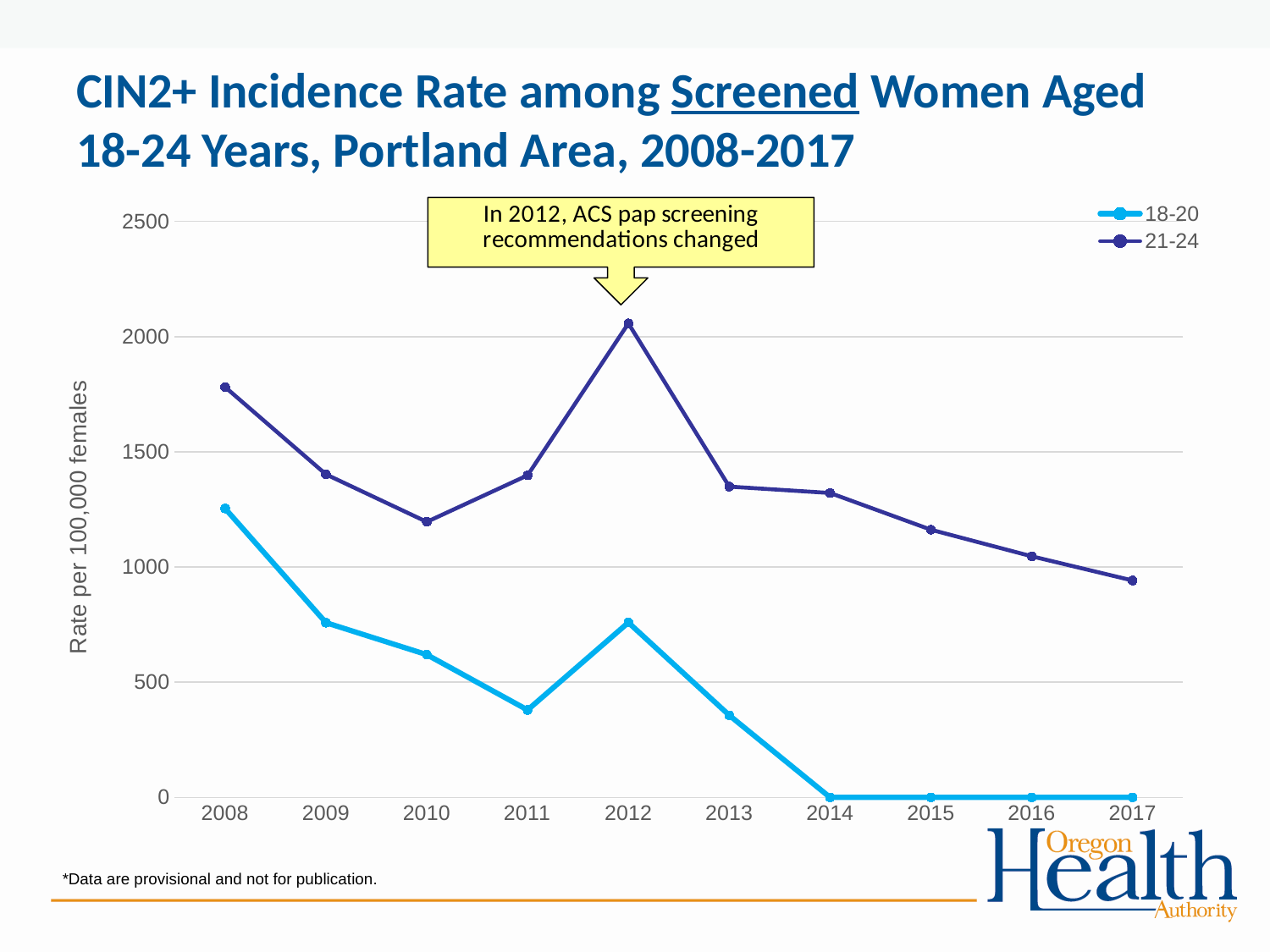
In which year is the 18-20 series at its highest? 2008 In which year is the 21-24 series at its lowest? 2017 What kind of chart is shown on the slide? Line chart Is the value for the 18-20 series in 2011 greater or less than 500? less How many series does the legend list? 2 Does the 21-24 series rise or fall from 2012 to 2017? Fall How many years are plotted along the x axis? 10 What is the value for the 18-20 series in 2015? 0 What does the callout box above the chart say happened in 2012? ACS pap screening recommendations changed Is the value for the 21-24 series in 2008 greater or less than 1500? greater In 2012, which series has the higher value, 18-20 or 21-24? 21-24 In which year is the 21-24 series at its highest? 2012